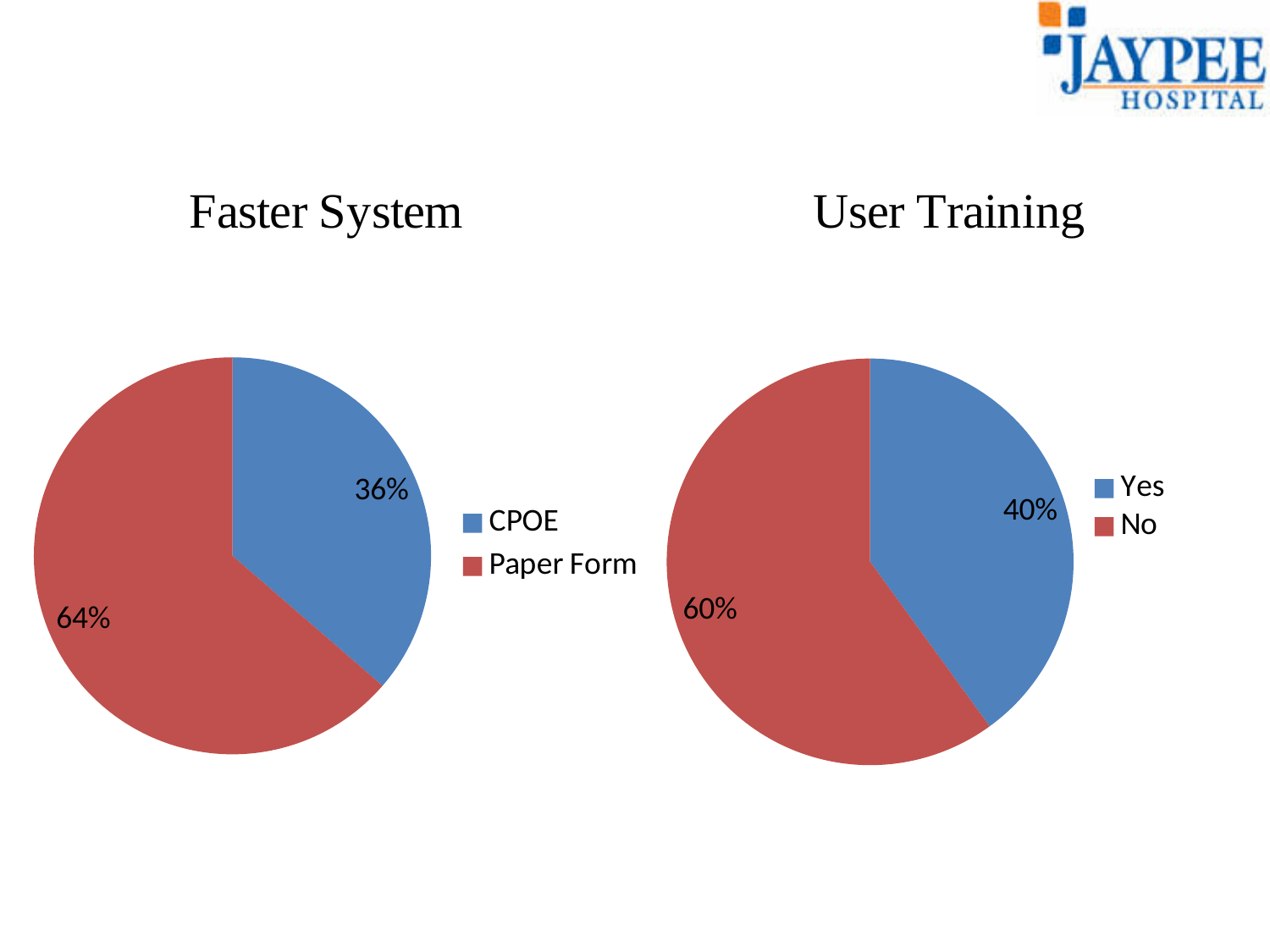
In the User Training chart, what share of the pie is No? 60% In the User Training chart, what share of the pie is Yes? 40% In the User Training chart, which category has the smallest slice? Yes In the Faster System chart, which colour represents CPOE? Blue In the Faster System chart, what share of the pie is CPOE? 36% In the Faster System chart, which category has the largest slice? Paper Form How many categories does the User Training chart show? 2 In the User Training chart, which is larger, Yes or No? No In the Faster System chart, what is the difference between the Paper Form and CPOE shares? 28% In the User Training chart, what is the difference between the No and Yes shares? 20% What kind of chart is the Faster System chart? Pie chart